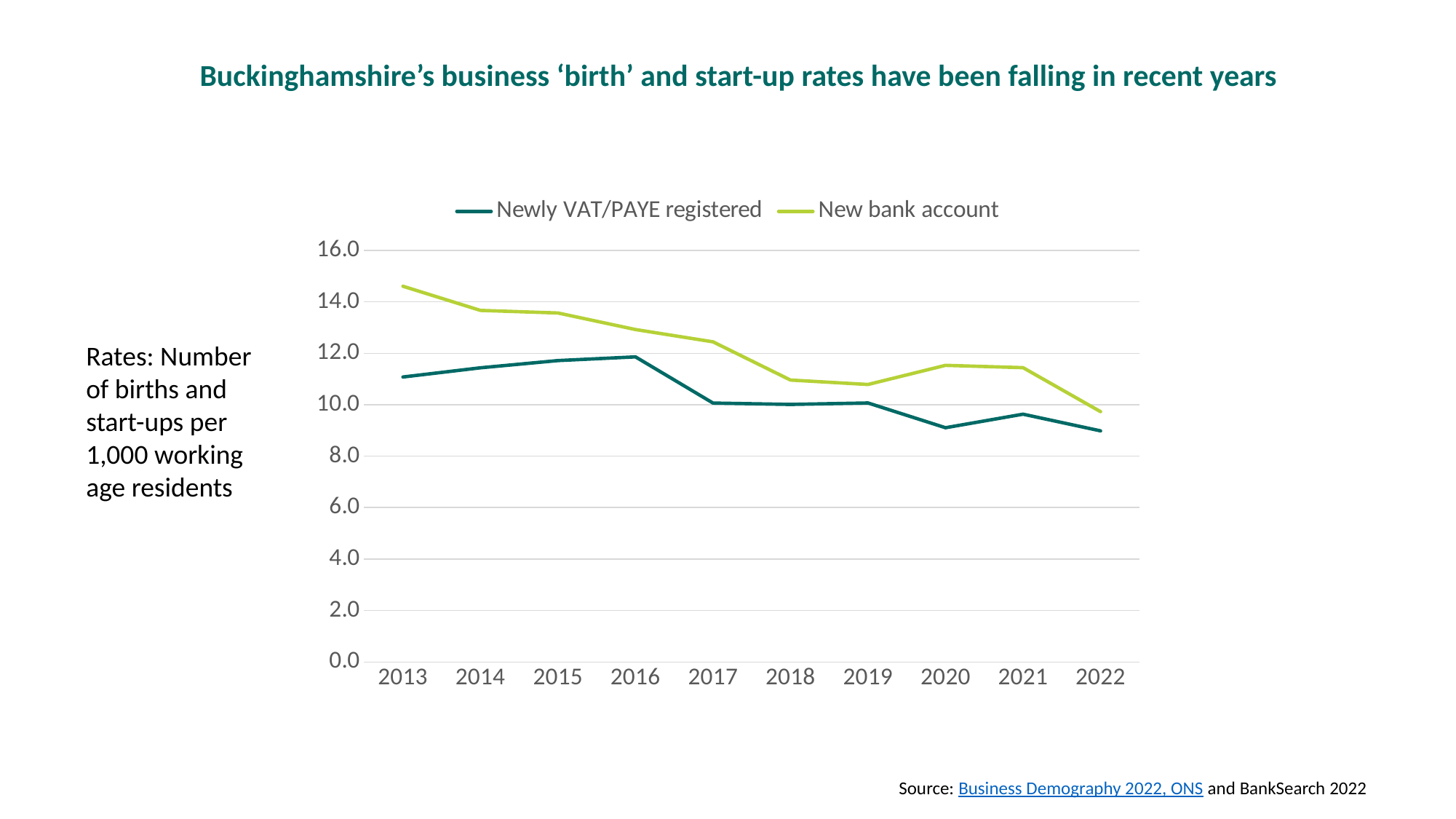
Is the New bank account value for 2018 greater or less than 12.0? less Which series has the higher value in 2013, Newly VAT/PAYE registered or New bank account? New bank account Is the New bank account value for 2013 greater or less than 14.0? greater Is the Newly VAT/PAYE registered value for 2022 greater or less than 10.0? less Does the New bank account rate rise or fall overall from 2013 to 2022? fall What is the title of the slide? Buckinghamshire's business 'birth' and start-up rates have been falling in recent years In which year is the New bank account rate lowest? 2022 How many series does the legend list? 2 What kind of chart is shown on the slide? line chart In which year is the New bank account rate highest? 2013 How many years are plotted along the x axis? 10 Which series has the higher value in 2020, Newly VAT/PAYE registered or New bank account? New bank account